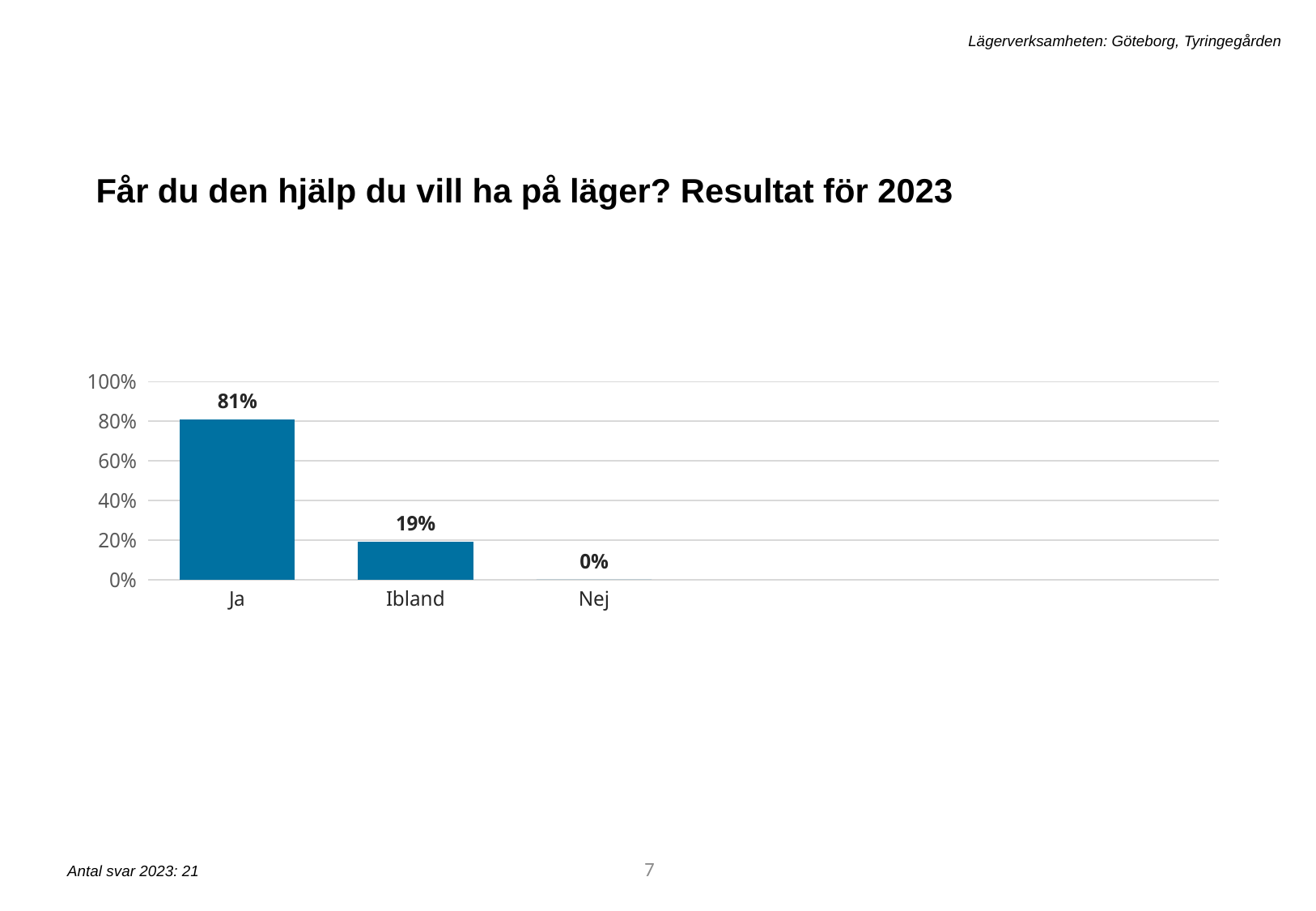
Which category has the lowest value? Nej How many categories are shown on the x axis? 3 Which category has the highest value? Ja What is the value for Ja? 81% Which is larger, the value for Ibland or the value for Nej? Ibland Is the value for Ja greater or less than 60%? greater What is the value for Nej? 0% What is the value for Ibland? 19% What kind of chart is shown on the slide? bar chart What is the title of the slide's chart? Får du den hjälp du vill ha på läger? Resultat för 2023 Is the value for Ibland greater or less than 40%? less What is the difference between the values for Ja and Ibland? 62%